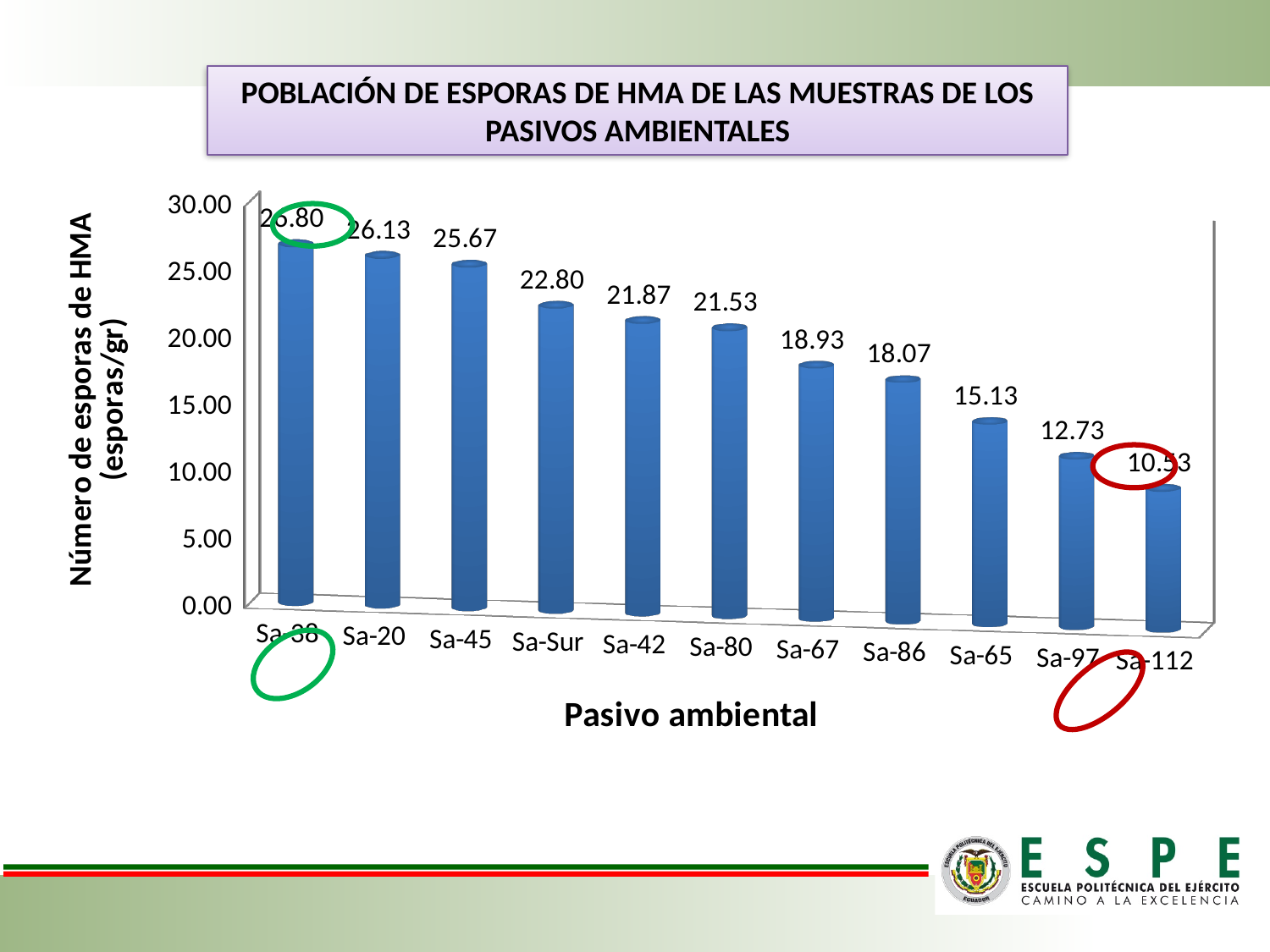
What is the value for Sa-45? 25.67 Which has a larger value, Sa-42 or Sa-80? Sa-42 What is the difference between the values for Sa-67 and Sa-86? 0.86 Do the values rise or fall from left to right along the x axis? fall What is the value for Sa-86? 18.07 What kind of chart is shown on the slide? bar chart Which pasivo ambiental has the lowest number of spores? Sa-112 What is the value for Sa-112? 10.53 Is the value for Sa-65 greater or less than 20.00? less What is the value for Sa-Sur? 22.80 What is the difference between the values for Sa-20 and Sa-97? 13.40 How many pasivos ambientales are shown on the x axis? 11